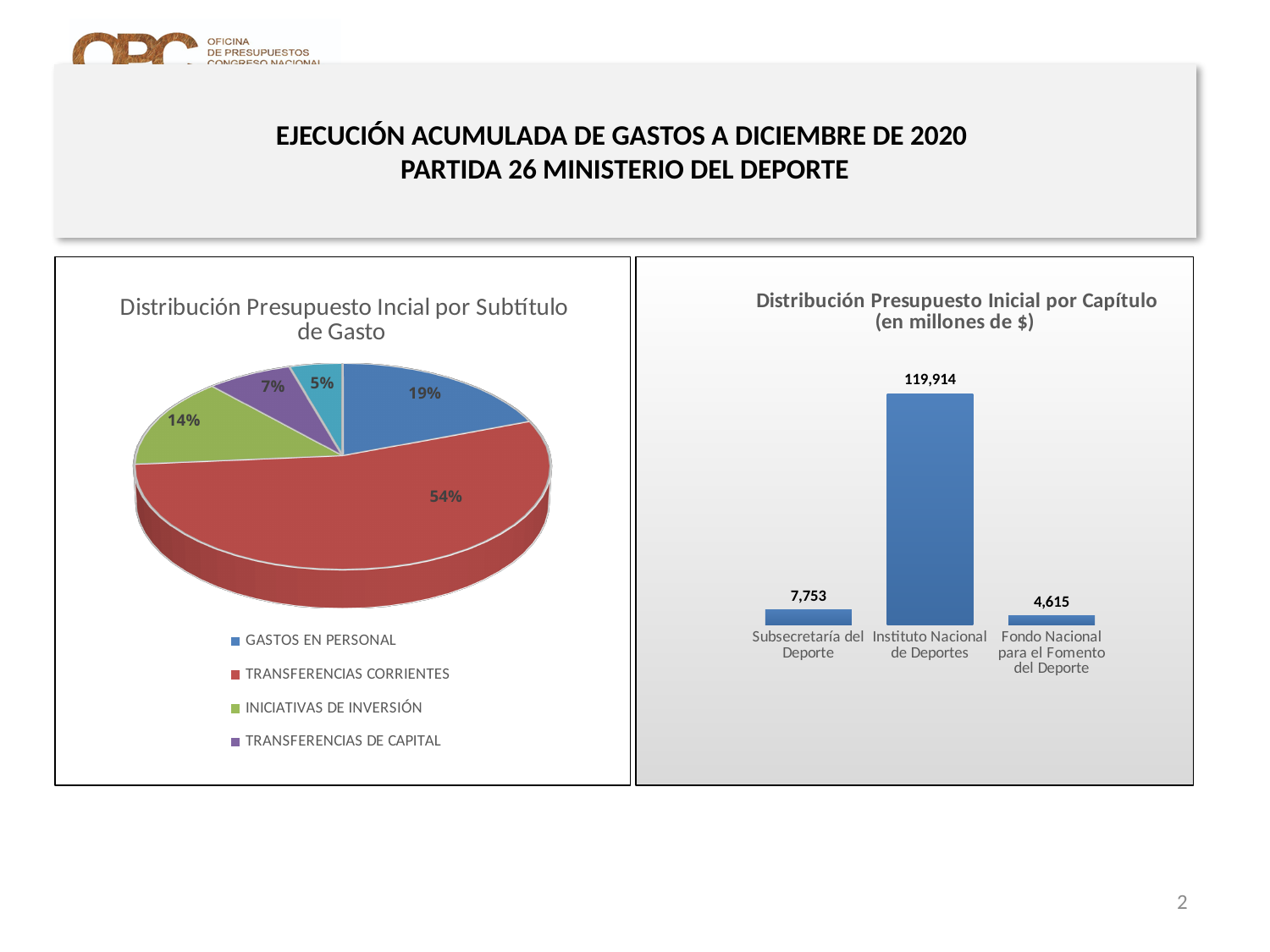
In the chart on the right, what is the difference between the values for Subsecretaría del Deporte and Fondo Nacional para el Fomento del Deporte? 3,138 In the pie chart on the left, what share does TRANSFERENCIAS DE CAPITAL have? 7% In the chart on the right, which category has the lowest value? Fondo Nacional para el Fomento del Deporte In the pie chart on the left, how many entries does the legend list? 4 In the pie chart on the left, what share does GASTOS EN PERSONAL have? 19% In the pie chart on the left, which category has the largest slice? TRANSFERENCIAS CORRIENTES In the chart on the right, what is the value for Subsecretaría del Deporte? 7,753 What kind of chart is the chart on the right of the slide? Bar chart In the pie chart 'Distribución Presupuesto Incial por Subtítulo de Gasto', what share does TRANSFERENCIAS CORRIENTES have? 54% In the chart on the right, what is the value for Fondo Nacional para el Fomento del Deporte? 4,615 In the chart 'Distribución Presupuesto Inicial por Capítulo (en millones de $)', what is the value for Instituto Nacional de Deportes? 119,914